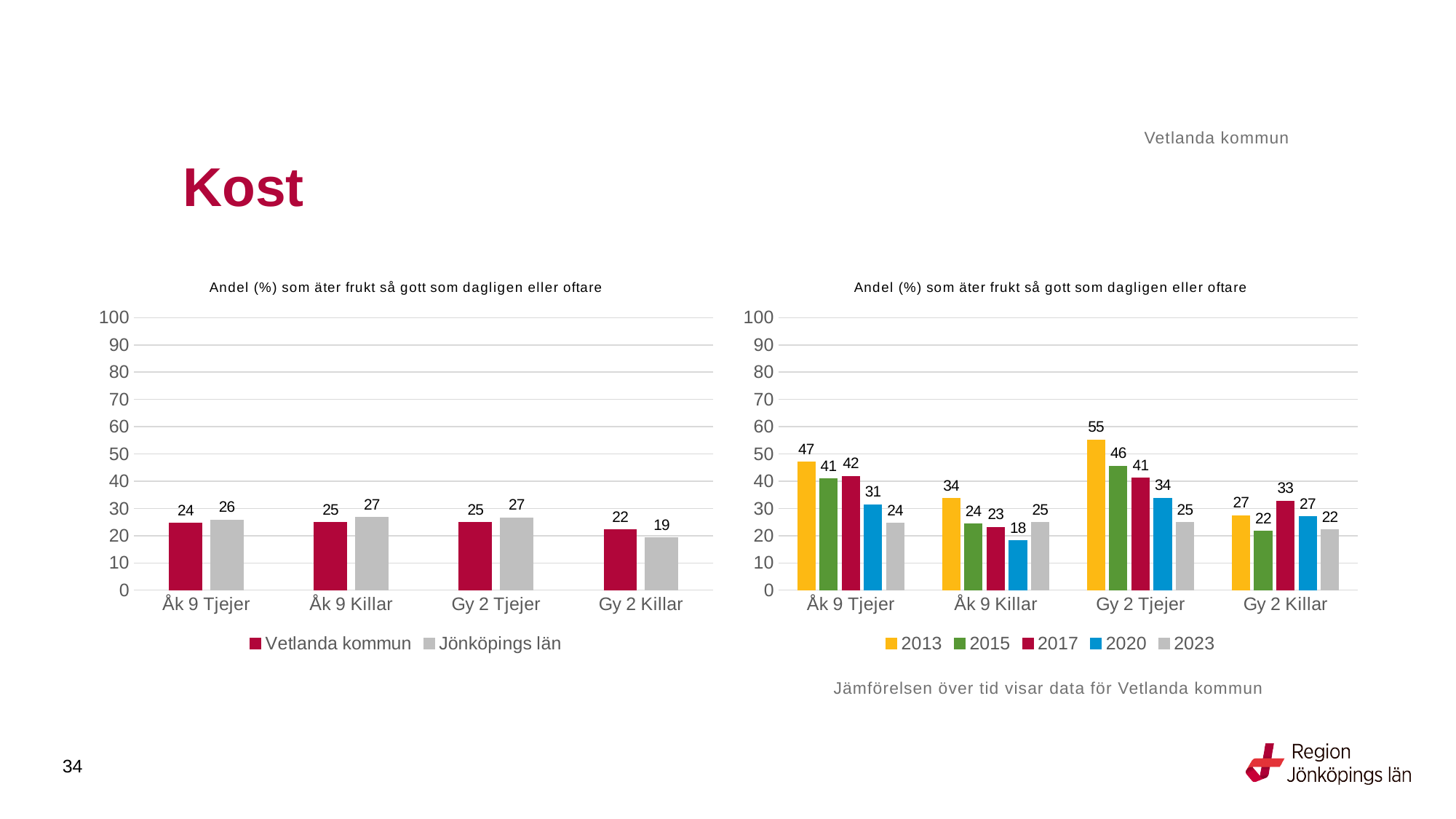
In the left chart, how many series does the legend list? 2 In the right chart, what is the value for 2020 for Åk 9 Killar? 18 In the right chart, what is the difference between the 2013 and 2023 values for Åk 9 Tjejer? 23 In the left chart, what is the value for Vetlanda kommun for Åk 9 Tjejer? 24 In the left chart, what is the value for Jönköpings län for Gy 2 Killar? 19 In the right chart, is the value for 2013 for Gy 2 Tjejer larger or smaller than the value for 2015 for Gy 2 Tjejer? larger In the right chart, which year has the highest value for Åk 9 Tjejer? 2013 What type of chart is the right chart? Bar chart In the right chart, what is the value for 2013 for Gy 2 Tjejer? 55 In the left chart, which category has the lowest value for Jönköpings län? Gy 2 Killar In the left chart, what is the difference between Jönköpings län and Vetlanda kommun for Åk 9 Killar? 2 In the right chart, how many series does the legend list? 5